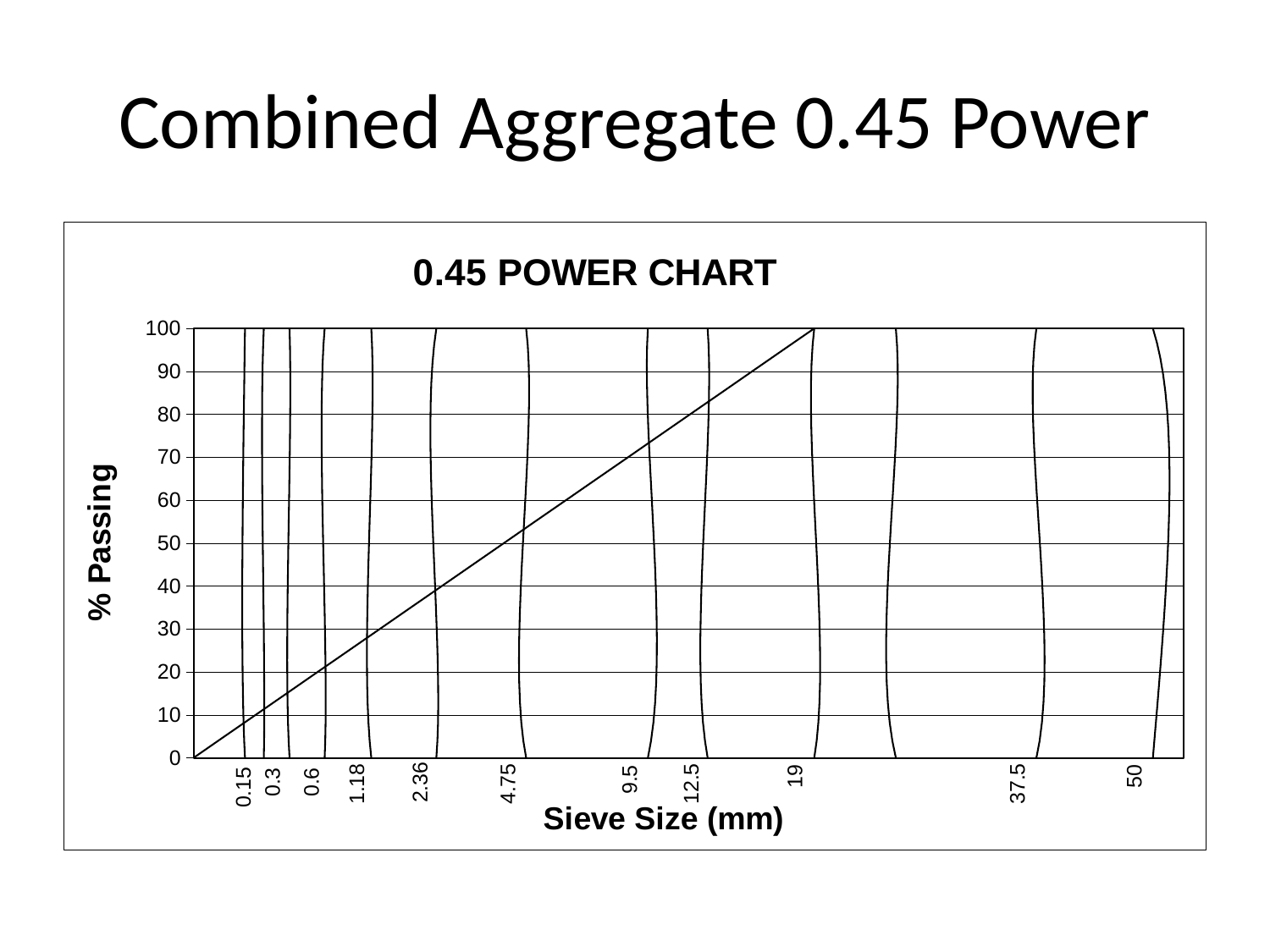
What kind of chart is shown on the slide? line chart At which labelled sieve size does the plotted line reach 100% passing? 19 What is the label of the vertical axis? % Passing Which sieve size has the higher % passing on the plotted line, 2.36 mm or 9.5 mm? 9.5 Does the plotted line rise or fall as sieve size increases along the x axis? rise What is the title printed inside the chart area? 0.45 POWER CHART How many sieve sizes are labelled on the horizontal axis? 11